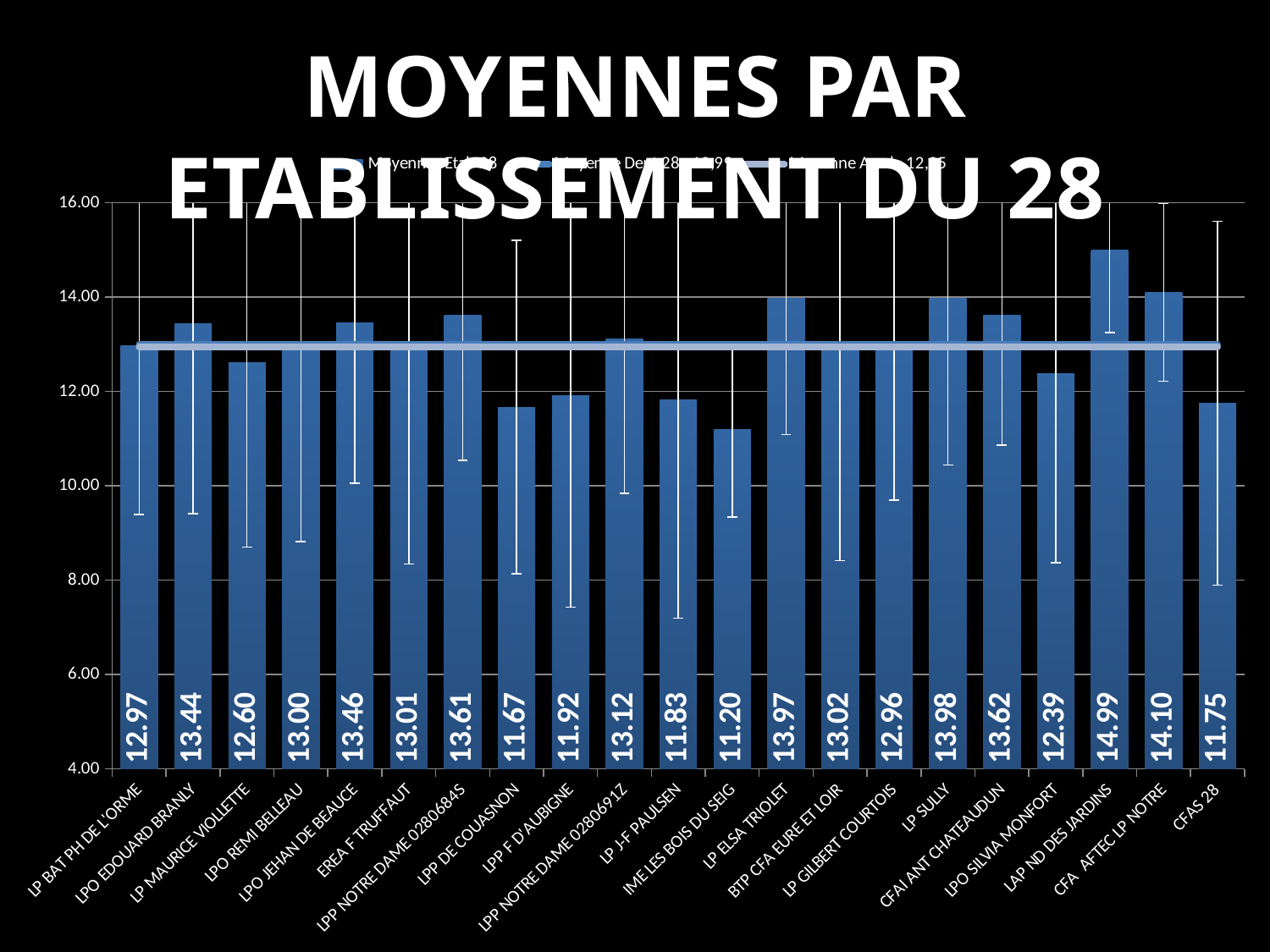
What is the value for CFAS 28? 11.75 How many establishments are shown on the chart? 21 Which establishment has the highest value? LAP ND DES JARDINS What is the value for LPO EDOUARD BRANLY? 13.44 What is the difference between the values for LAP ND DES JARDINS and IME LES BOIS DU SEIG? 3.79 What kind of chart is shown on the slide? combination bar and line chart Which is larger, the value for LP SULLY or the value for LP ELSA TRIOLET? LP SULLY Is the value for LPP DE COUASNON greater or less than 12.00? less What is the value for LAP ND DES JARDINS? 14.99 What is the difference between the values for CFA AFTEC LP NOTRE and LPO SILVIA MONFORT? 1.71 Which establishment has the lowest value? IME LES BOIS DU SEIG What is the value for IME LES BOIS DU SEIG? 11.20